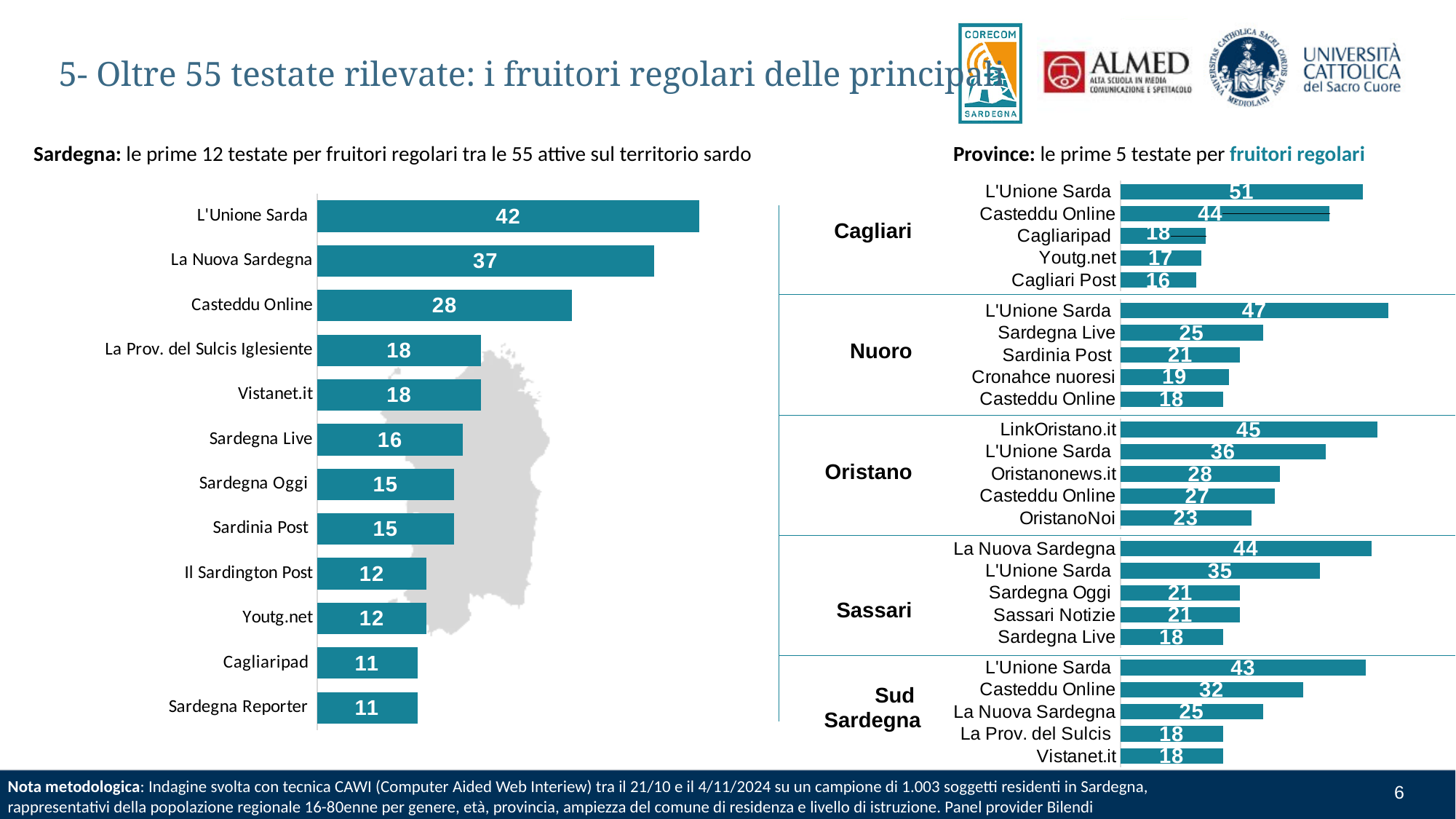
What kind of chart is the Sardegna chart on the left? bar chart In the Province chart on the right, what is the value for L'Unione Sarda in Cagliari? 51 In the Sardegna chart on the left, what is the value for L'Unione Sarda? 42 In the Sardegna chart on the left, what is the value for Sardegna Live? 16 In the Province chart on the right, which is larger in Sassari: La Nuova Sardegna or L'Unione Sarda? La Nuova Sardegna In the Province chart on the right, what is the difference between L'Unione Sarda and Sardegna Live in Nuoro? 22 In the Sardegna chart on the left, what is the difference between La Nuova Sardegna and Casteddu Online? 9 How many provinces are shown in the Province chart on the right? 5 In the Province chart on the right, which testata has the highest value in Oristano? LinkOristano.it In the Sardegna chart on the left, how many testate are listed? 12 In the Province chart on the right, what is the value for Casteddu Online in Sud Sardegna? 32 In the Sardegna chart on the left, which testata has the highest value? L'Unione Sarda